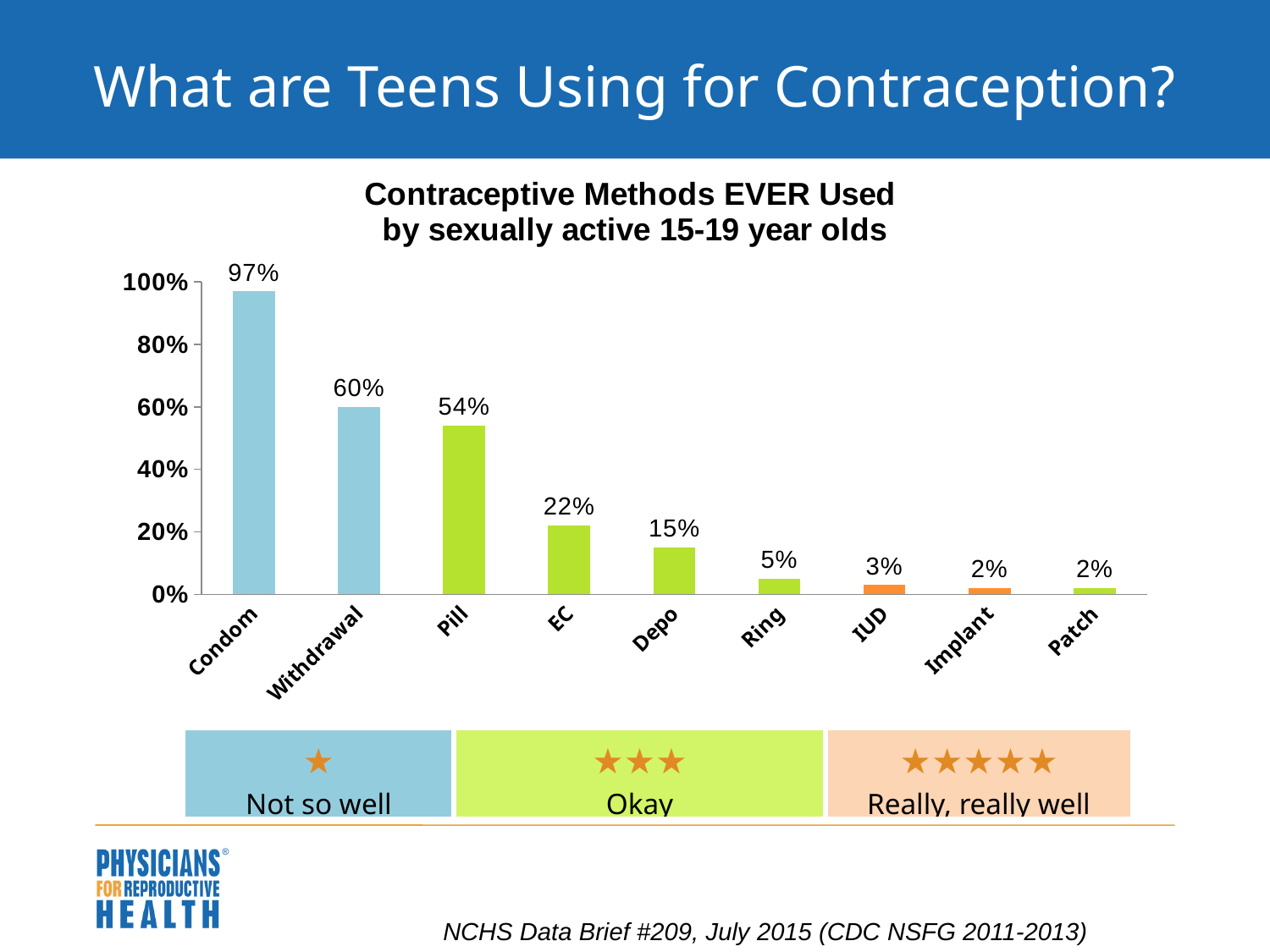
What is the value shown for Withdrawal? 60% Is the value for Pill greater or less than 40%? greater Which has a higher value, Ring or IUD? Ring Which contraceptive method has the highest percentage of ever use? Condom What percentage is shown for EC? 22% What is the title of the chart? Contraceptive Methods EVER Used by sexually active 15-19 year olds What percentage of sexually active 15-19 year olds have ever used a condom? 97% What is the difference between the percentages for Condom and Withdrawal? 37% What kind of chart is shown on the slide? Bar chart What is the value shown for Depo? 15% What is the difference between the percentages for Pill and EC? 32% How many contraceptive methods are shown on the x axis? 9